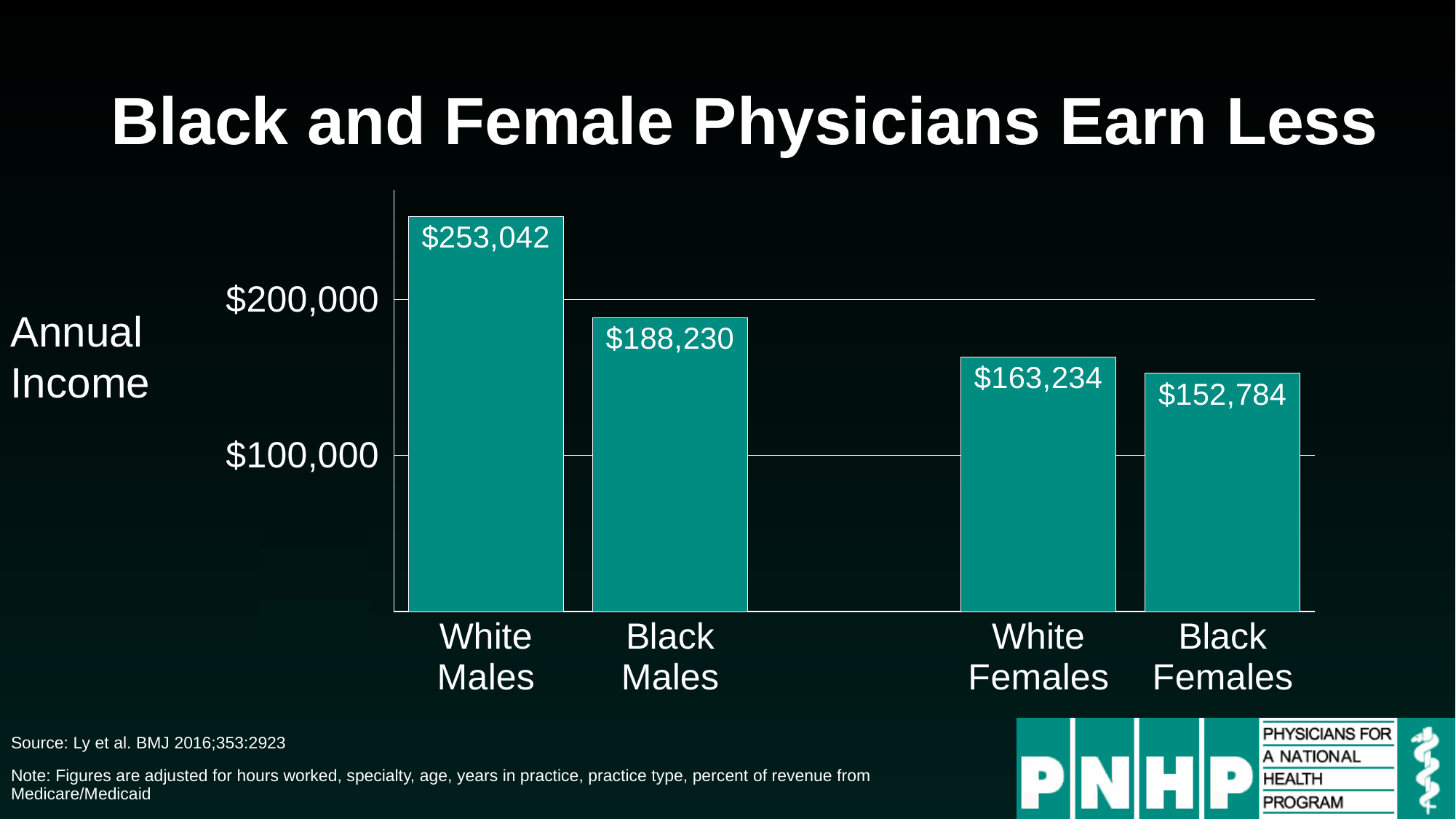
Which group earns more, Black Males or White Females? Black Males What is the difference in annual income between White Males and Black Males? $64,812 What is the title of the slide? Black and Female Physicians Earn Less How many groups are shown in the chart? 4 What is the annual income shown for Black Males? $188,230 What is the difference in annual income between White Females and Black Females? $10,450 Which group has the highest annual income? White Males Is the annual income for Black Males greater or less than $200,000? less What is the annual income shown for Black Females? $152,784 What is the annual income shown for White Males? $253,042 What kind of chart is shown on the slide? bar chart Which group has the lowest annual income? Black Females